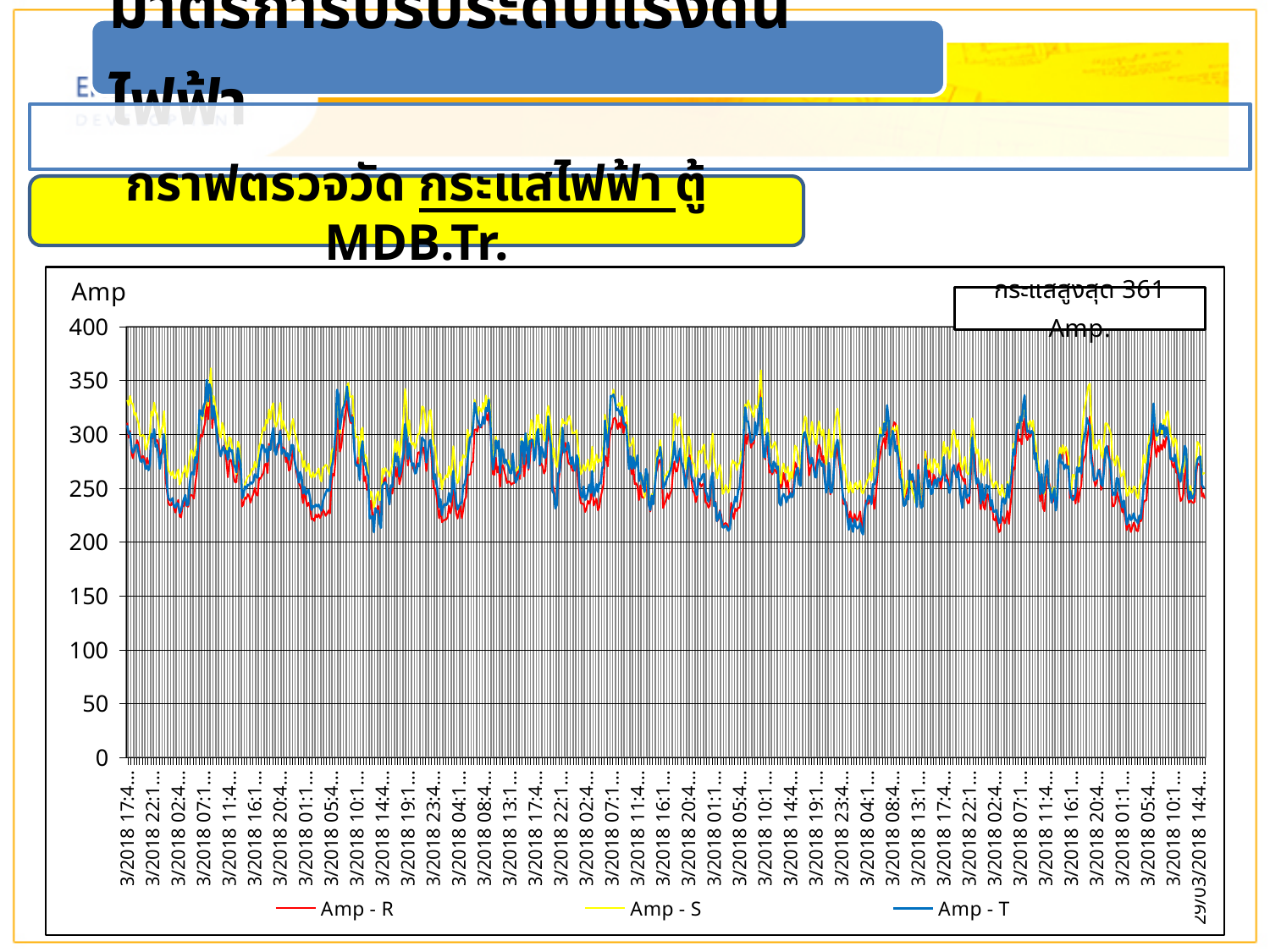
Are all the plotted current values greater or less than 400? less What unit label is shown at the top of the vertical axis? Amp What is the interval between consecutive tick marks on the vertical axis? 50 What kind of chart is shown on the slide? line chart What colour is the line for Amp - S? yellow What is the highest tick value shown on the vertical axis? 400 What are the names of the series listed in the legend? Amp - R, Amp - S, Amp - T What is the maximum current stated in the annotation box on the chart? 361 Amp. Is the lowest value reached by Amp - T greater or less than 250? less Are all the plotted current values greater or less than 150? greater How many series does the legend list? 3